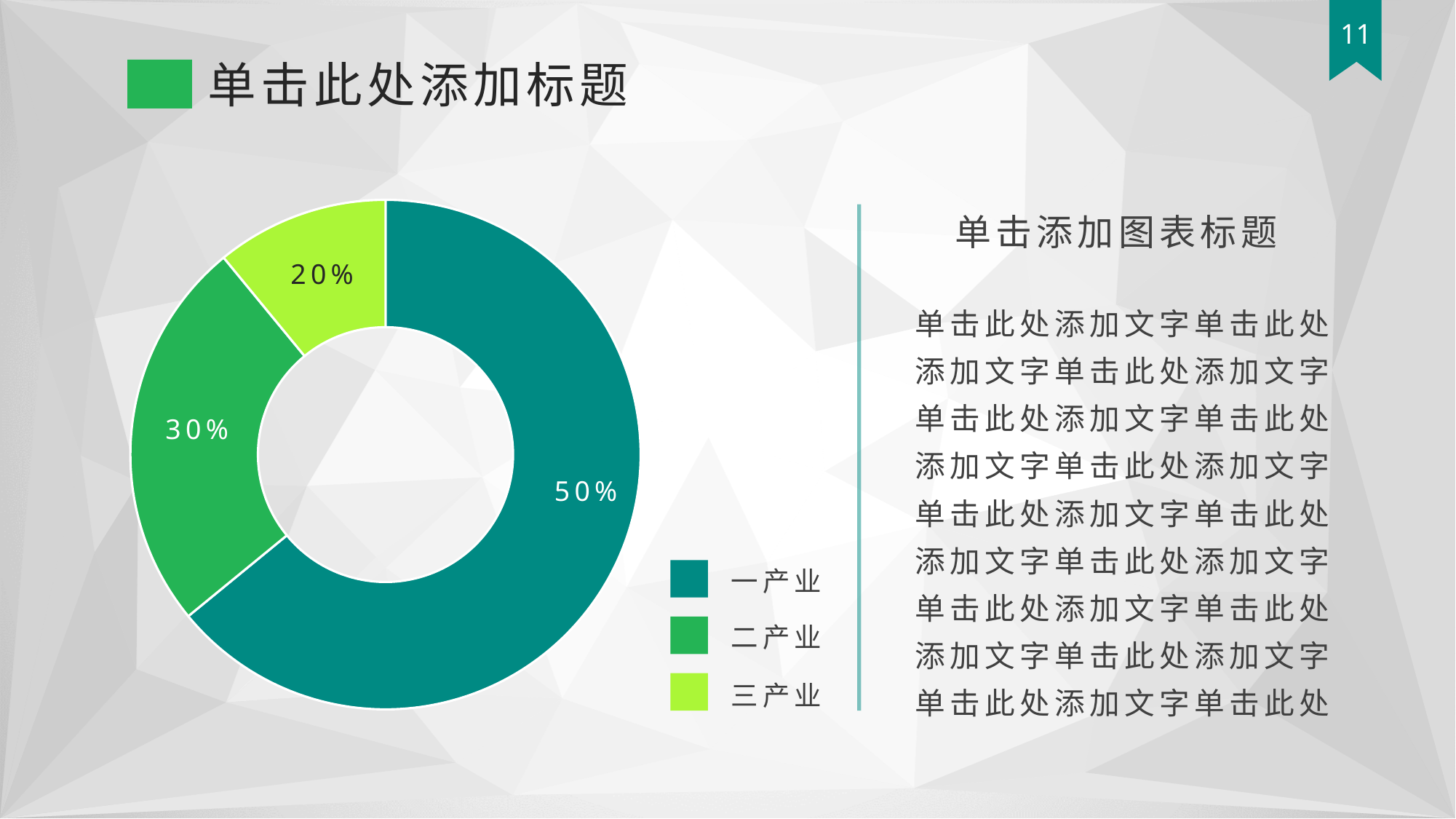
What is the difference between the shares of 一产业 and 三产业? 30% How many categories does the chart show? 3 What is the value for 一产业? 50% What is the difference between the shares of 二产业 and 三产业? 10% Which is larger, the share of 二产业 or 三产业? 二产业 What colour is the slice for 三产业? Light green Which category has the largest share? 一产业 Which category has the smallest share? 三产业 What is the value for 二产业? 30% What is the value for 三产业? 20% What kind of chart is shown on the slide? Doughnut (pie) chart How many entries does the legend list? 3